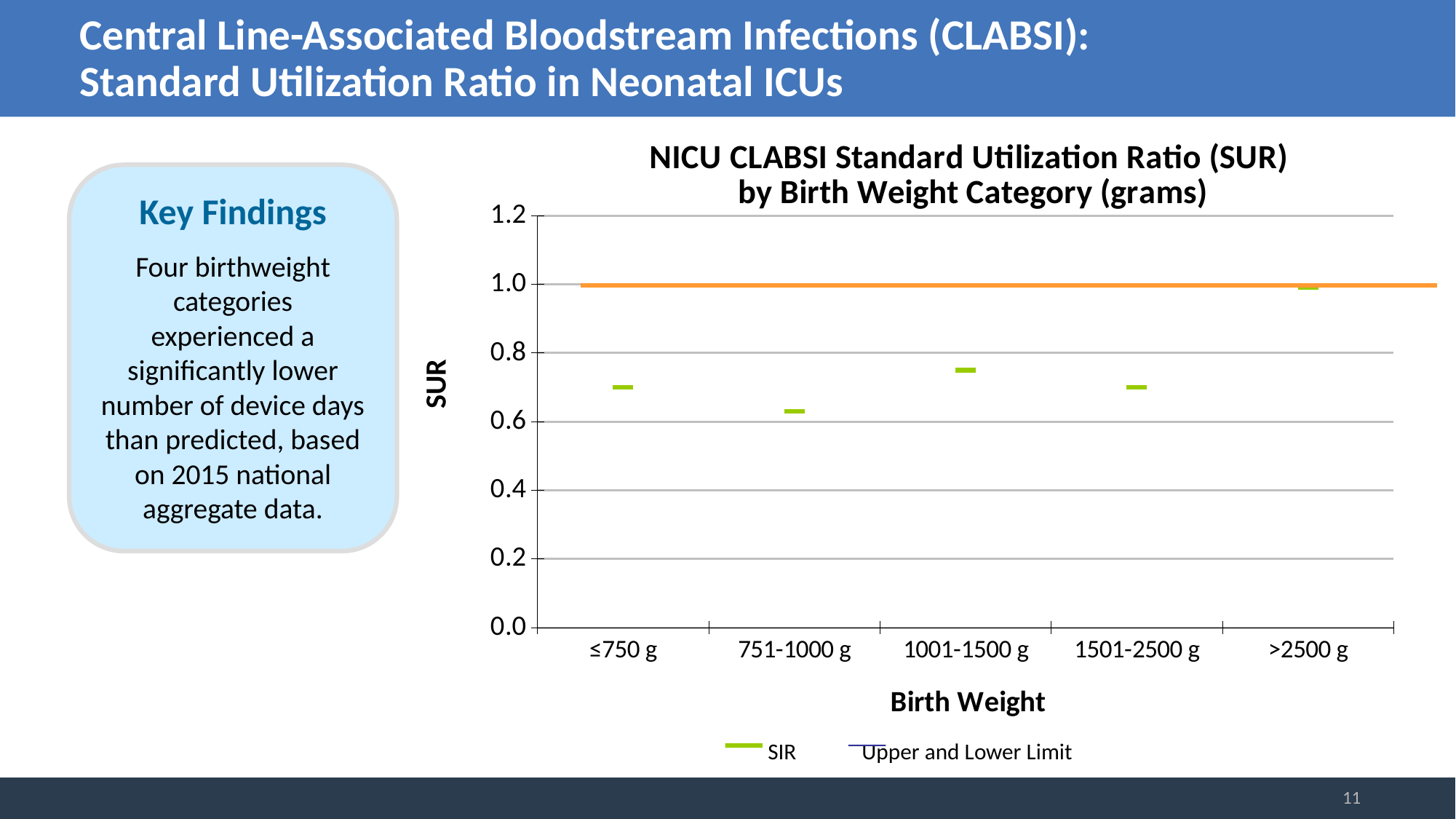
Is the SIR value for ≤750 g greater or less than 0.8? less Is the SIR value for 751-1000 g greater or less than 0.6? greater Is the SIR value for >2500 g greater or less than 0.8? greater Which birth weight category has the lowest SIR value? 751-1000 g What is the title of the chart? NICU CLABSI Standard Utilization Ratio (SUR) by Birth Weight Category (grams) Which birth weight category has the highest SIR value? >2500 g How many series does the chart legend list? 2 Which has the larger SIR value, 1001-1500 g or 751-1000 g? 1001-1500 g How many birth weight categories are shown on the x axis of the chart? 5 What are the two entries in the chart legend? SIR; Upper and Lower Limit